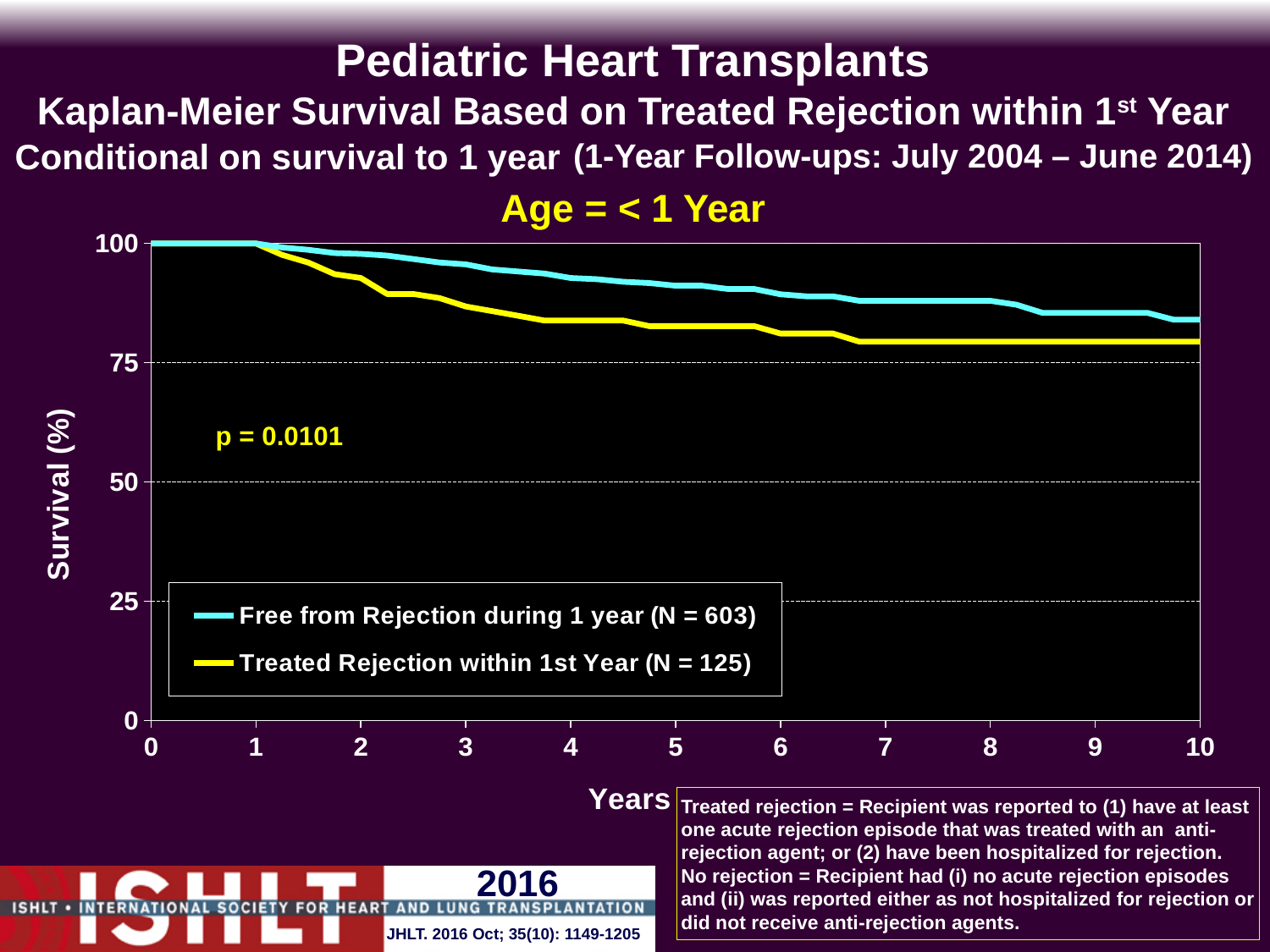
What is the survival (%) for the Free from Rejection during 1 year group at year 0? 100 What p-value is shown on the chart? p = 0.0101 Is the survival for the Treated Rejection within 1st Year group at year 3 greater or less than 100? less How many series does the legend list? 2 Do the survival curves rise or fall as years increase? fall What is the N for the Treated Rejection within 1st Year group in the legend? 125 What is the survival (%) for the Treated Rejection within 1st Year group at year 0? 100 Is the survival for the Free from Rejection during 1 year group at year 10 greater or less than 75? greater Is the survival for the Treated Rejection within 1st Year group at year 10 greater or less than 75? greater At year 10, which group has the lower survival? Treated Rejection within 1st Year What kind of chart is shown on the slide? line chart At year 5, which group has the higher survival: Free from Rejection during 1 year or Treated Rejection within 1st Year? Free from Rejection during 1 year